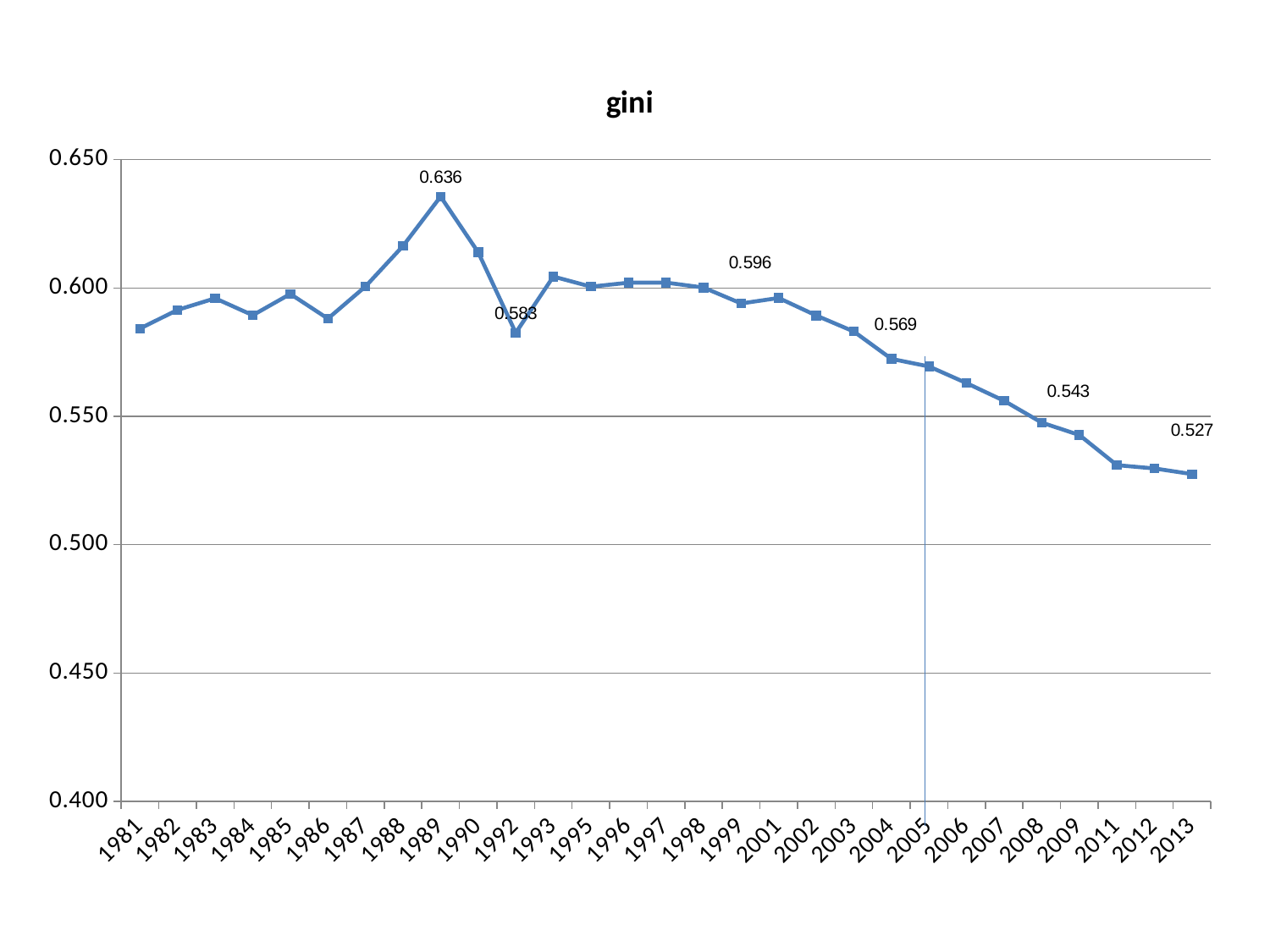
What is the title of the chart? gini What is the gini value for 2009? 0.543 What is the gini value for 2013? 0.527 Which year has the larger gini value, 1989 or 1992? 1989 What is the difference between the gini value in 1989 and in 2013? 0.109 What kind of chart is shown on the slide? line chart Which year has the lowest gini value? 2013 Is the gini value for 1981 greater or less than 0.600? less Does the gini value rise or fall from 2005 to 2013? fall What is the gini value for 1989? 0.636 What is the gini value for 1992? 0.583 Which year has the highest gini value? 1989